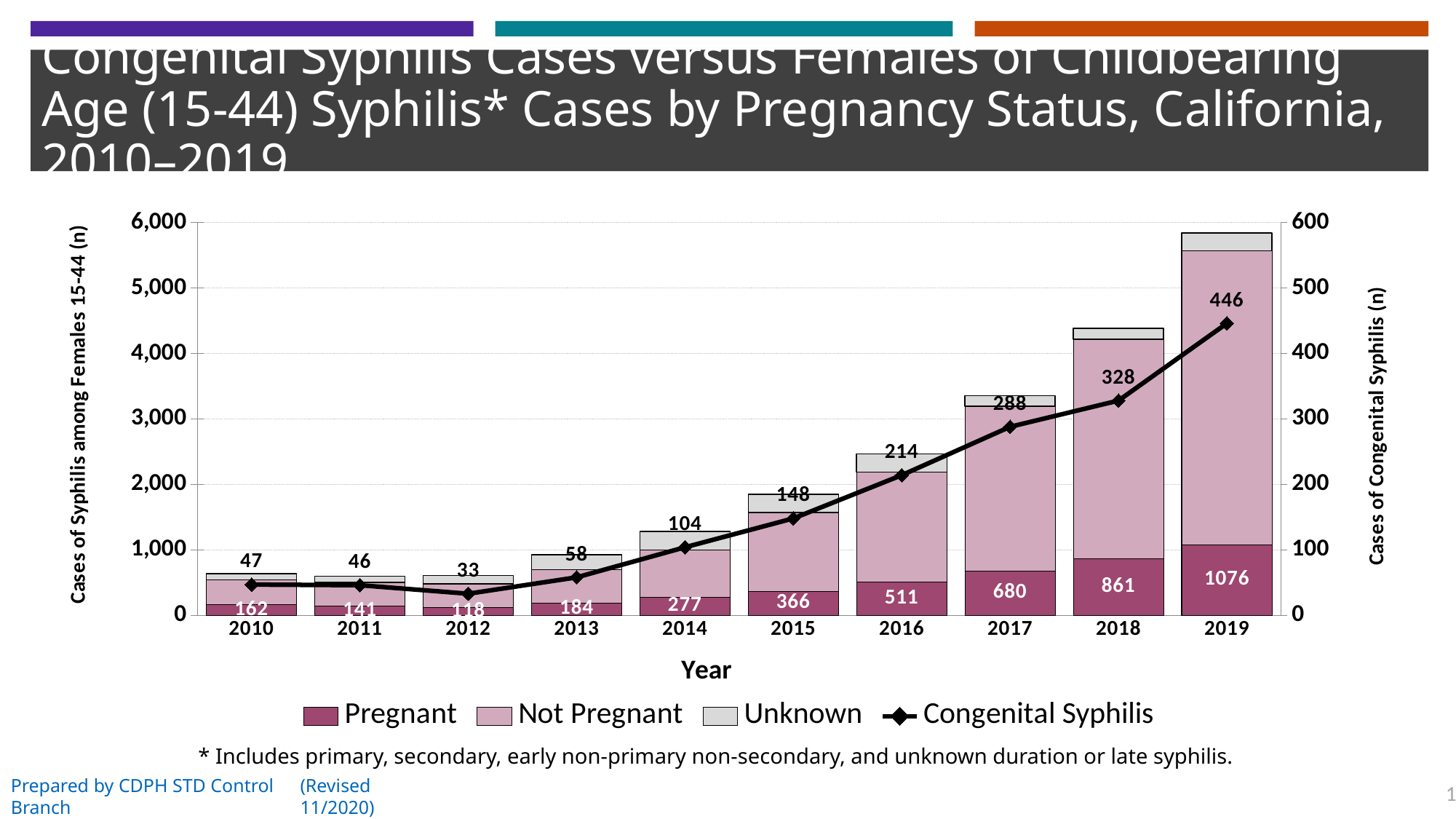
How many years are shown on the x axis? 10 In which year is the Pregnant value highest? 2019 What is the value of the Congenital Syphilis line in 2014? 104 How many cases of congenital syphilis are shown for 2019? 446 Is the total stacked bar for 2019 greater or less than 5,000 on the left axis? greater What is the overall trend of the Congenital Syphilis line from 2012 to 2019? rising Which is larger, the Pregnant value in 2010 or in 2011? 2010 What is the difference between the Pregnant values for 2018 and 2017? 181 What is the difference between the Congenital Syphilis values for 2019 and 2018? 118 How many series does the legend list? 4 In which year is the Congenital Syphilis value lowest? 2012 What is the value of the Pregnant series in 2017? 680